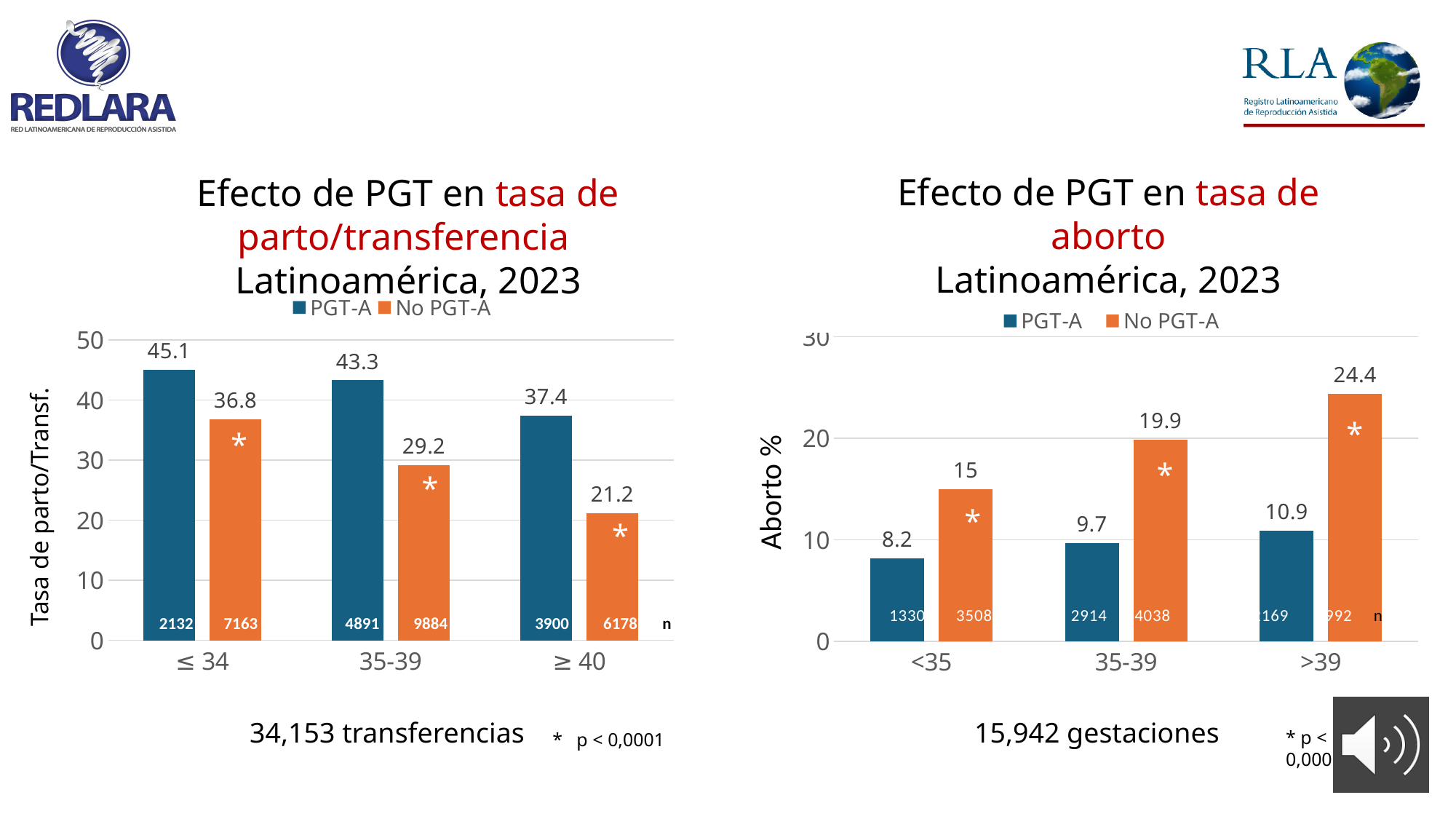
What type of chart is the left chart (tasa de parto/transferencia)? bar chart In the left chart (tasa de parto/transferencia), what is the PGT-A value for the ≤ 34 age group? 45.1 In the left chart (tasa de parto/transferencia), what is the No PGT-A value for the ≥ 40 age group? 21.2 In the right chart (tasa de aborto), which is larger for the <35 age group: PGT-A or No PGT-A? No PGT-A How many series does the legend of the right chart (tasa de aborto) list? 2 In the left chart (tasa de parto/transferencia), what is the difference between the PGT-A and No PGT-A values for the 35-39 age group? 14.1 In the left chart (tasa de parto/transferencia), which age group has the highest PGT-A value? ≤ 34 In the right chart (tasa de aborto), what is the No PGT-A value for the >39 age group? 24.4 In the left chart (tasa de parto/transferencia), do the No PGT-A values rise or fall as age group increases? fall In the right chart (tasa de aborto), what is the PGT-A value for the 35-39 age group? 9.7 In the right chart (tasa de aborto), what is the difference between the No PGT-A and PGT-A values for the >39 age group? 13.5 In the right chart (tasa de aborto), which age group has the lowest PGT-A value? <35